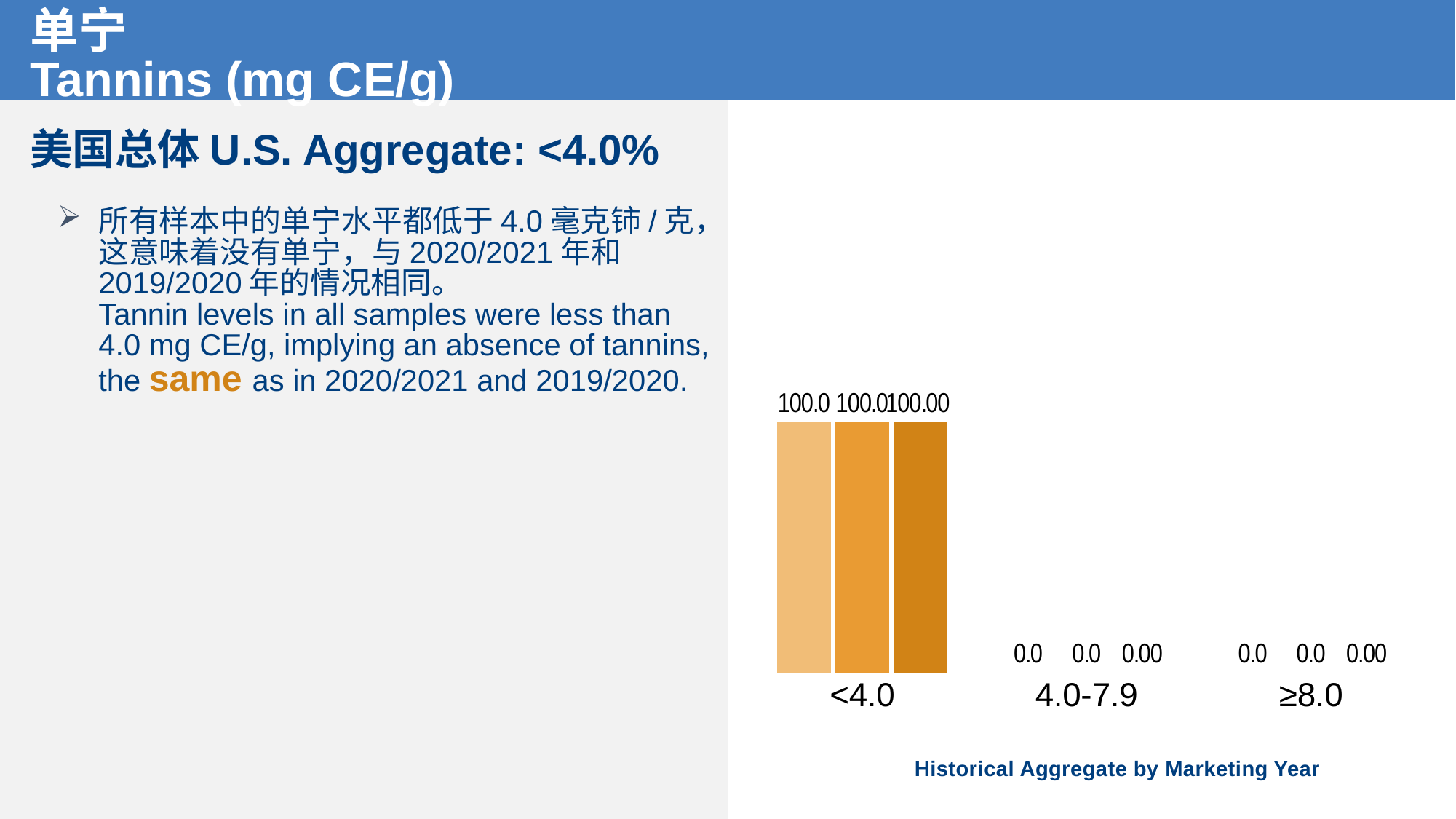
How many bars are plotted in each category of the chart? 3 What is the difference between the leftmost bar in the <4.0 category and the leftmost bar in the ≥8.0 category? 100.0 What is the caption printed below the chart? Historical Aggregate by Marketing Year Which category has the highest values in the chart? <4.0 What is the data label on the rightmost bar in the ≥8.0 category? 0.00 Which is larger: the middle bar in the <4.0 category or the middle bar in the 4.0-7.9 category? <4.0 What is the data label on the leftmost bar in the 4.0-7.9 category? 0.0 What is the data label on the rightmost (darkest) bar in the <4.0 category? 100.00 What is the data label on the leftmost bar in the <4.0 category? 100.0 What kind of chart is shown on the slide? bar chart How many categories are shown on the x axis of the chart? 3 What is the label of the rightmost category on the x axis? ≥8.0